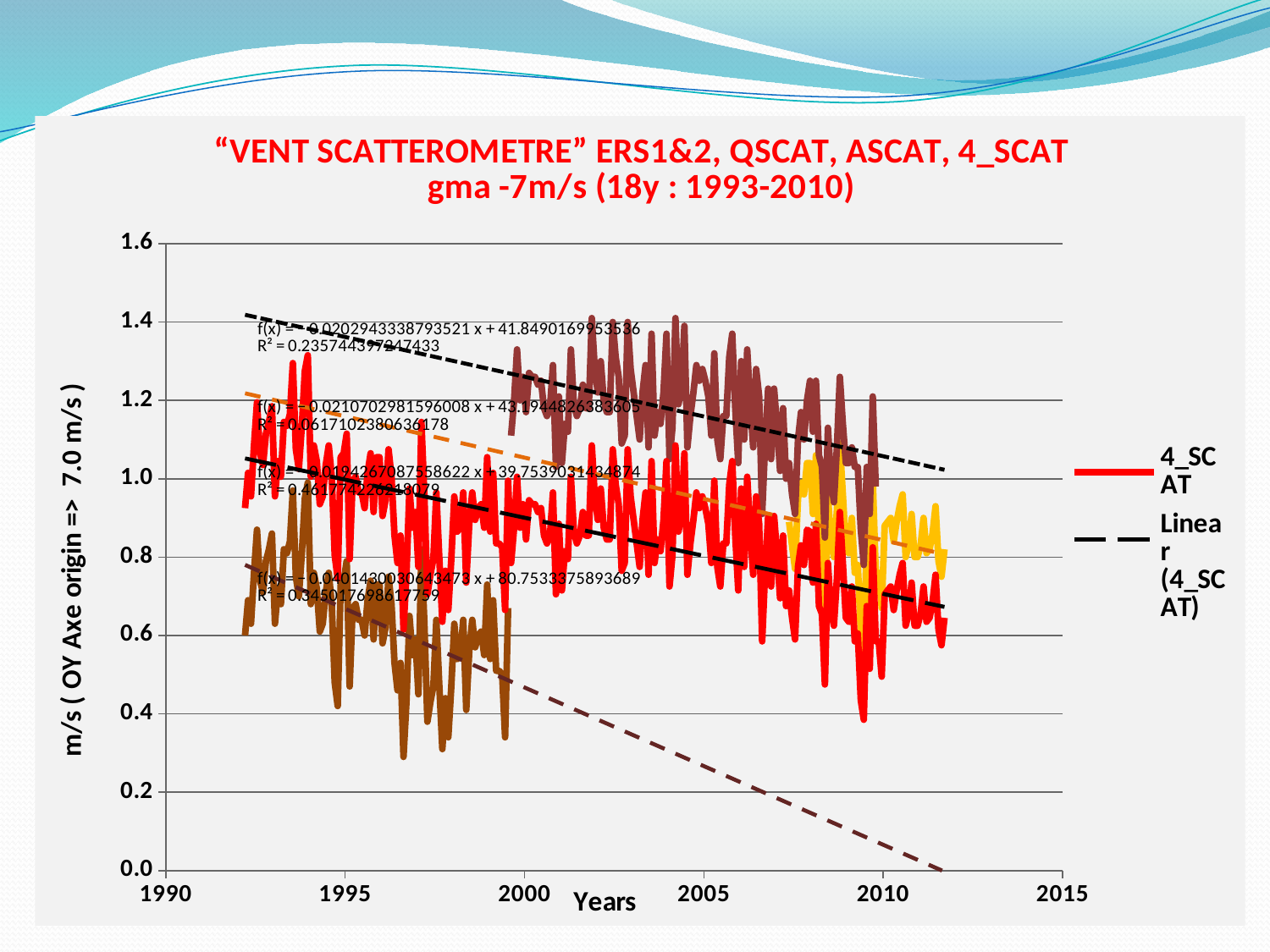
Does the 4_SCAT series rise or fall along the x axis from the early 1990s to around 2010? fall Is the Linear (4_SCAT) trend line value at 1995 greater or less than 0.8? greater What is the title of the x axis? Years How many series does the legend list? 2 Does the dashed Linear (4_SCAT) trend line slope upward or downward over time? downward What is the highest tick value shown on the y axis? 1.6 Is the Linear (4_SCAT) trend line value at 2010 greater or less than 0.8? less What kind of chart is shown on the slide? line chart